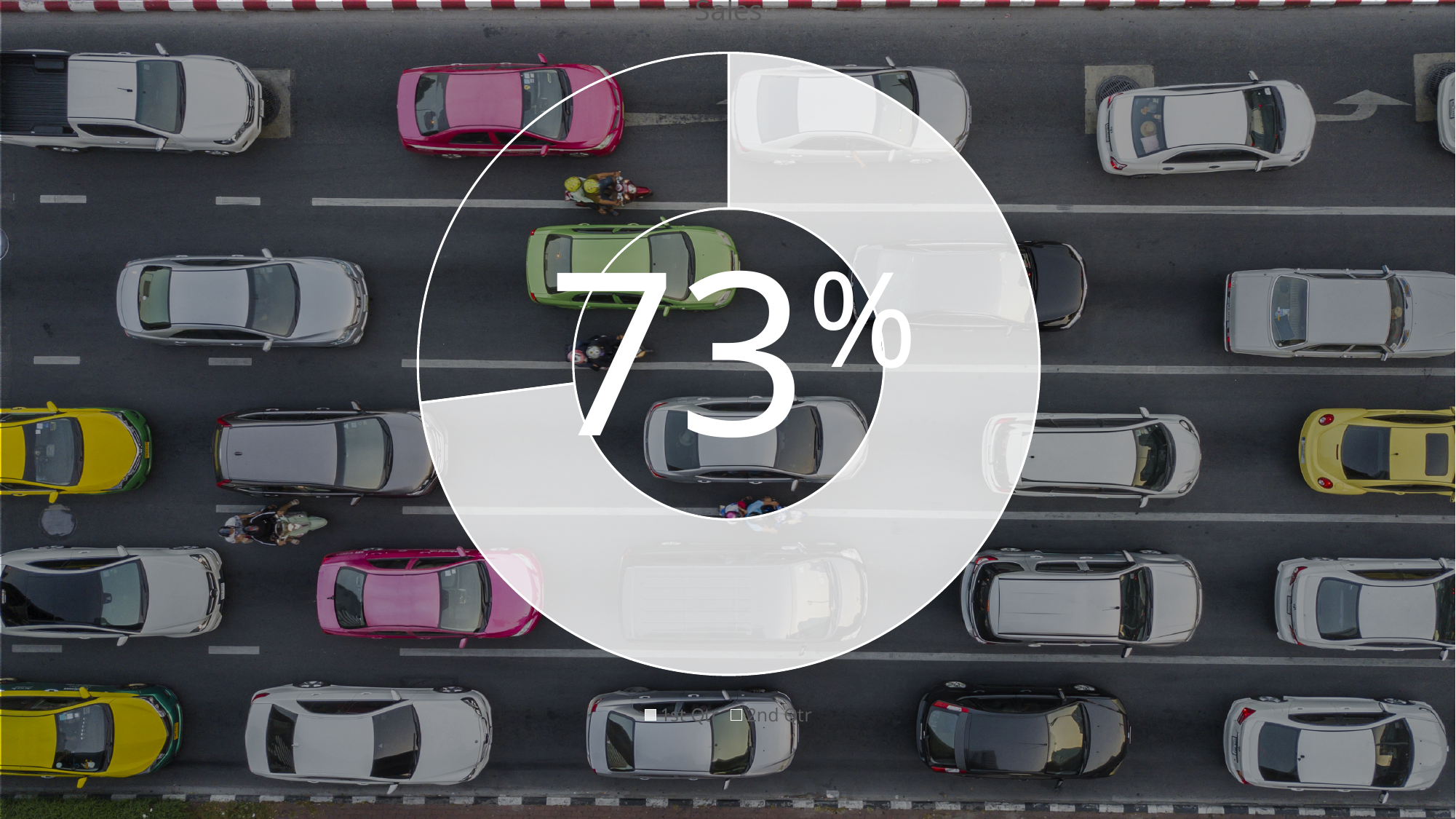
What share of the doughnut does the larger slice represent? 73% Is the larger slice's share greater or less than 50%? greater What are the two legend entries of the chart? 1st Qtr and 2nd Qtr How many entries does the chart's legend list? 2 What kind of chart is shown on the slide? doughnut chart What percentage is printed in the centre of the doughnut chart? 73% What share of the doughnut does the smaller slice represent? 27% How many slices does the doughnut chart have? 2 What is the title of the chart? Sales Which legend entry corresponds to the larger slice, 1st Qtr or 2nd Qtr? 1st Qtr